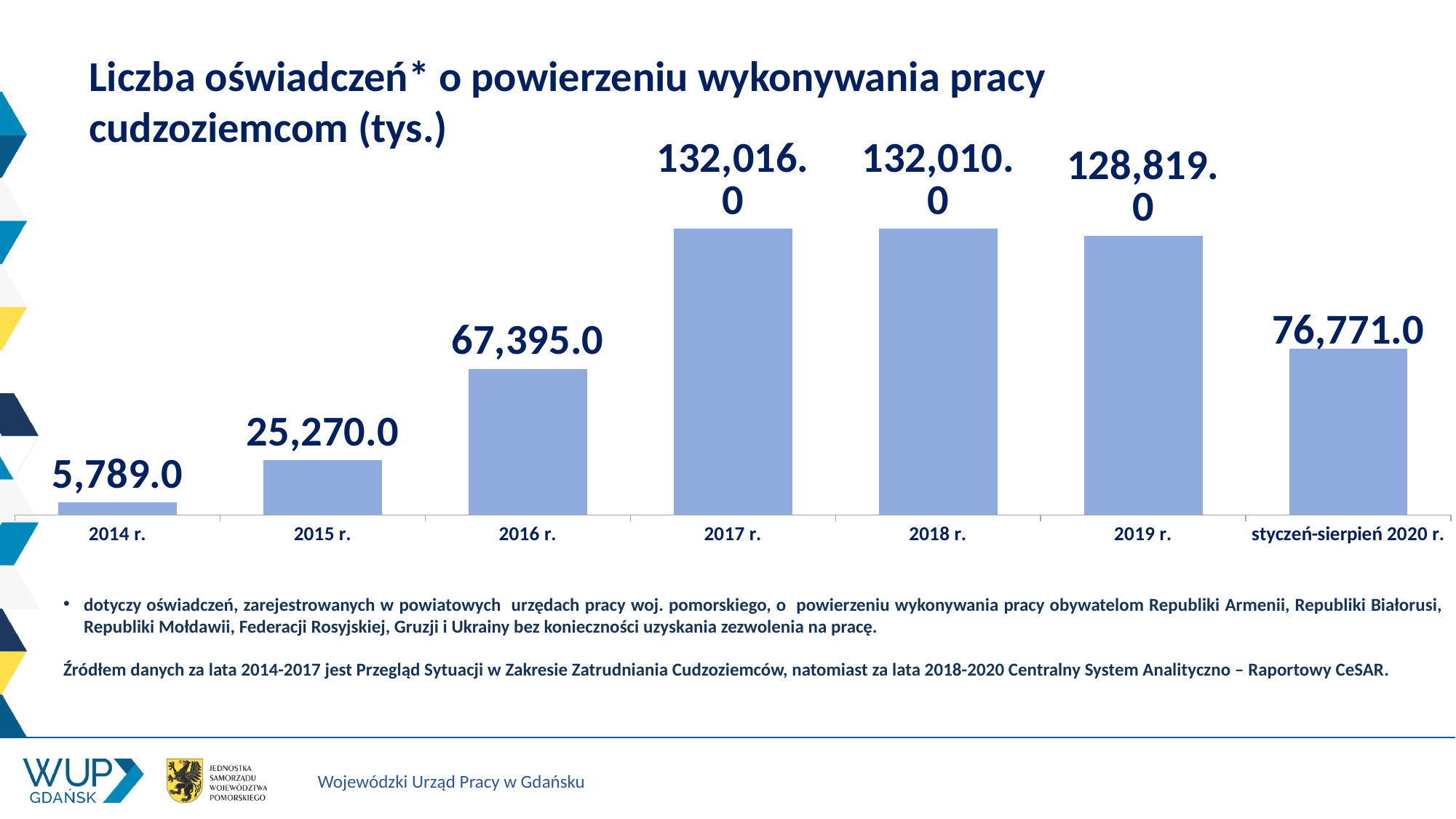
What is the value for 2016 r.? 67,395.0 What is the difference between the values for 2019 r. and styczeń-sierpień 2020 r.? 52,048.0 What type of chart is shown on the slide? Bar chart What is the value for 2019 r.? 128,819.0 What is the value for styczeń-sierpień 2020 r.? 76,771.0 What is the value for 2014 r.? 5,789.0 Which category has the highest value? 2017 r. How many categories (bars) are plotted in the chart? 7 Which is larger, the value for 2016 r. or the value for styczeń-sierpień 2020 r.? styczeń-sierpień 2020 r. Which category has the lowest value? 2014 r. What is the difference between the values for 2017 r. and 2016 r.? 64,621.0 Do the values rise or fall from 2014 r. to 2017 r.? Rise